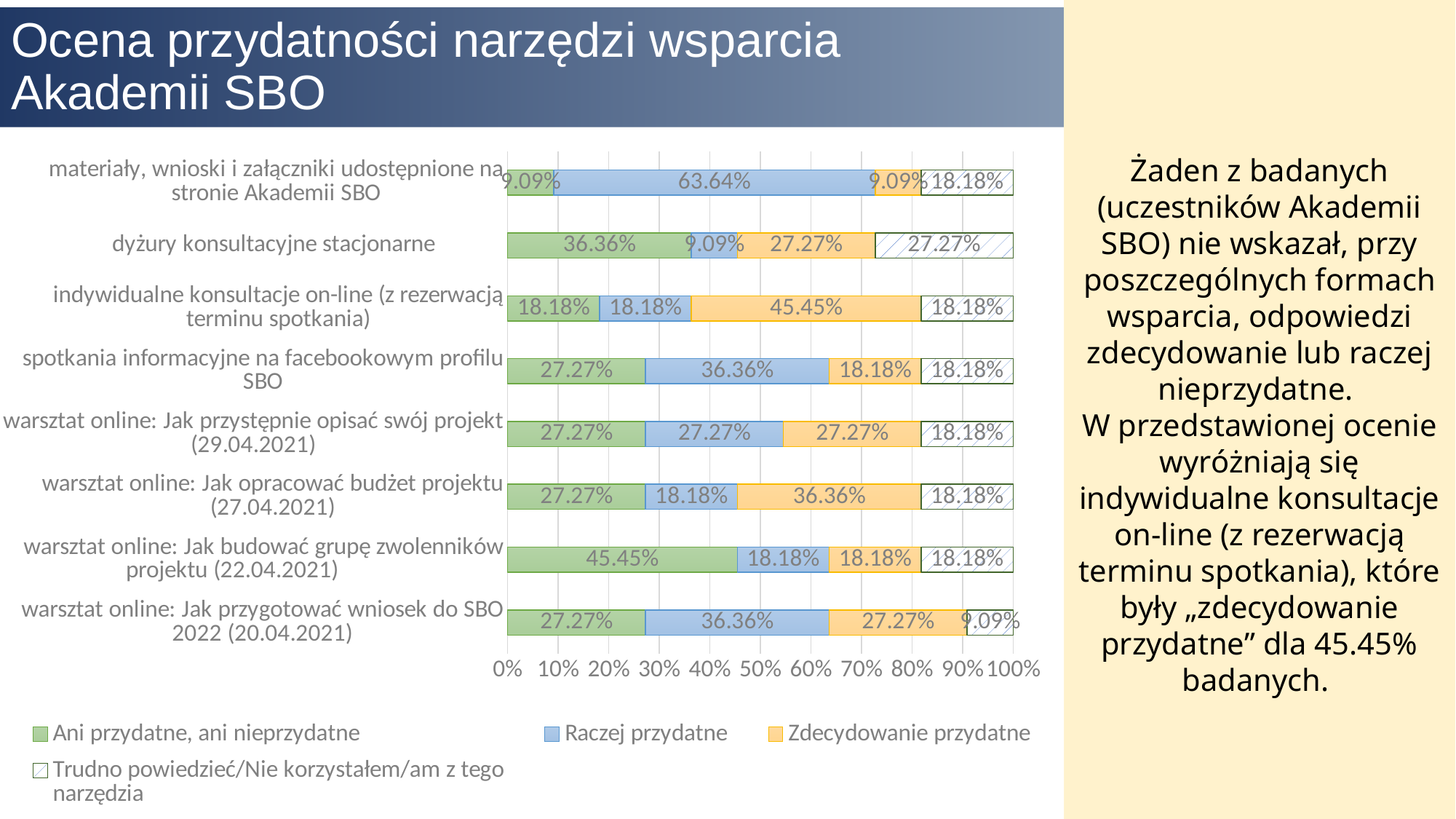
What is the 'Trudno powiedzieć/Nie korzystałem/am z tego narzędzia' value for 'dyżury konsultacyjne stacjonarne'? 27.27% Which category has the highest 'Zdecydowanie przydatne' share? indywidualne konsultacje on-line (z rezerwacją terminu spotkania) Which category has the highest 'Raczej przydatne' share? materiały, wnioski i załączniki udostępnione na stronie Akademii SBO Which category has the lowest 'Trudno powiedzieć/Nie korzystałem/am z tego narzędzia' share? warsztat online: Jak przygotować wniosek do SBO 2022 (20.04.2021) What kind of chart is shown on the slide? Stacked bar chart How many series does the legend list? 4 What is the difference between the 'Zdecydowanie przydatne' values for 'indywidualne konsultacje on-line (z rezerwacją terminu spotkania)' and 'warsztat online: Jak opracować budżet projektu (27.04.2021)'? 9.09% What is the 'Zdecydowanie przydatne' value for 'indywidualne konsultacje on-line (z rezerwacją terminu spotkania)'? 45.45% How many categories (support tools) are shown on the chart? 8 What is the 'Ani przydatne, ani nieprzydatne' value for 'warsztat online: Jak budować grupę zwolenników projektu (22.04.2021)'? 45.45% What percentage of respondents rated 'materiały, wnioski i załączniki udostępnione na stronie Akademii SBO' as 'Raczej przydatne'? 63.64% Which is larger for 'dyżury konsultacyjne stacjonarne': the 'Ani przydatne, ani nieprzydatne' value or the 'Raczej przydatne' value? Ani przydatne, ani nieprzydatne